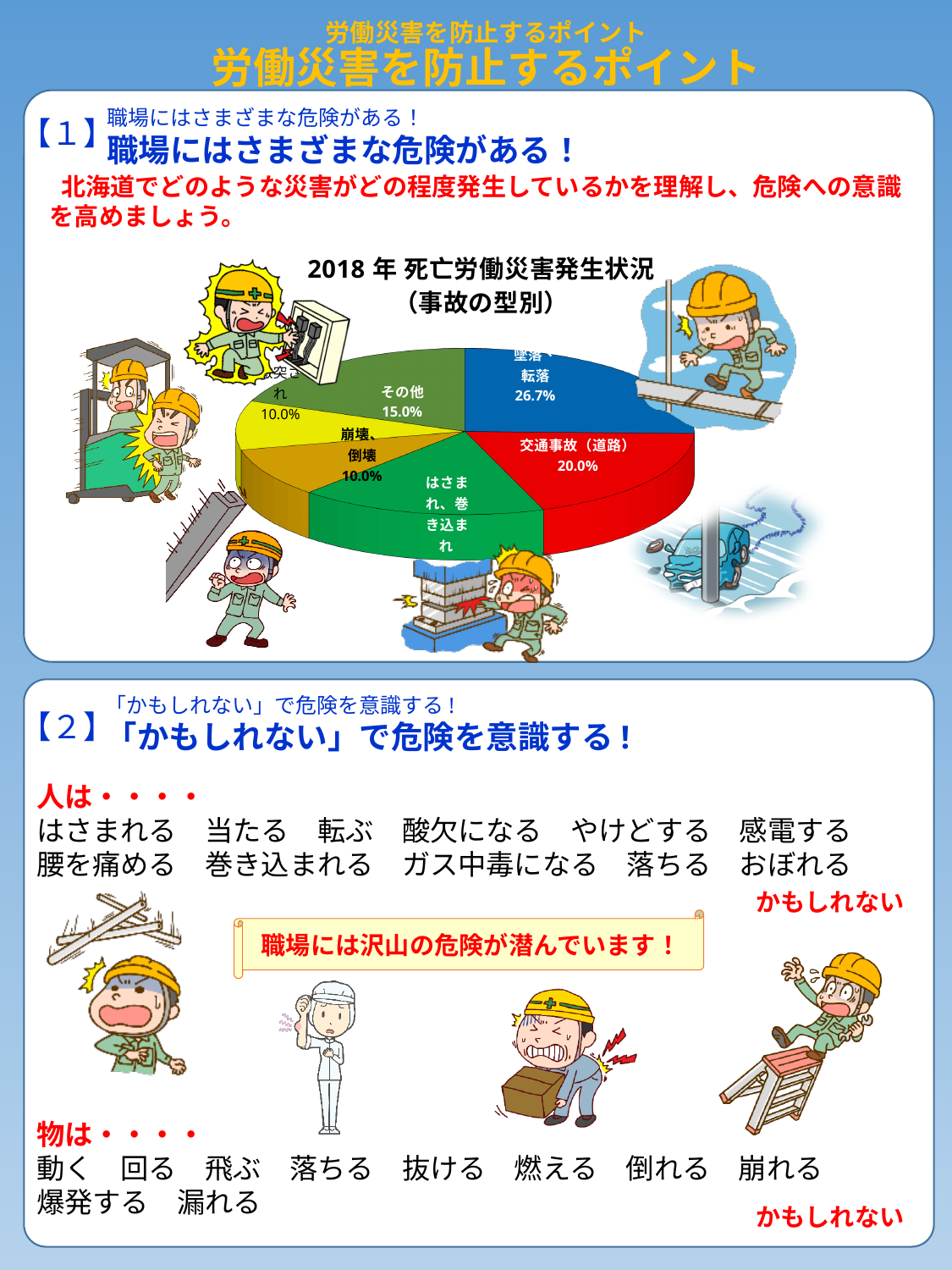
What percentage does the 墜落・転落 slice show in the pie chart? 26.7% What percentage is shown for 交通事故（道路） in the pie chart? 20.0% What percentage is shown for その他 in the pie chart? 15.0% How many percentage points larger is 墜落・転落 than 交通事故（道路） in the pie chart? 6.7% What is the difference between the その他 share and the 崩壊、倒壊 share in the pie chart? 5.0% Which is larger in the pie chart, 交通事故（道路） or その他? 交通事故（道路） How many slices does the pie chart have? 6 What is the title of the pie chart? 2018年 死亡労働災害発生状況（事故の型別） What kind of chart is shown on the slide? pie chart What percentage is shown for 崩壊、倒壊 in the pie chart? 10.0% Which accident type has the largest share in the pie chart? 墜落・転落 Which year does the pie chart's data refer to? 2018